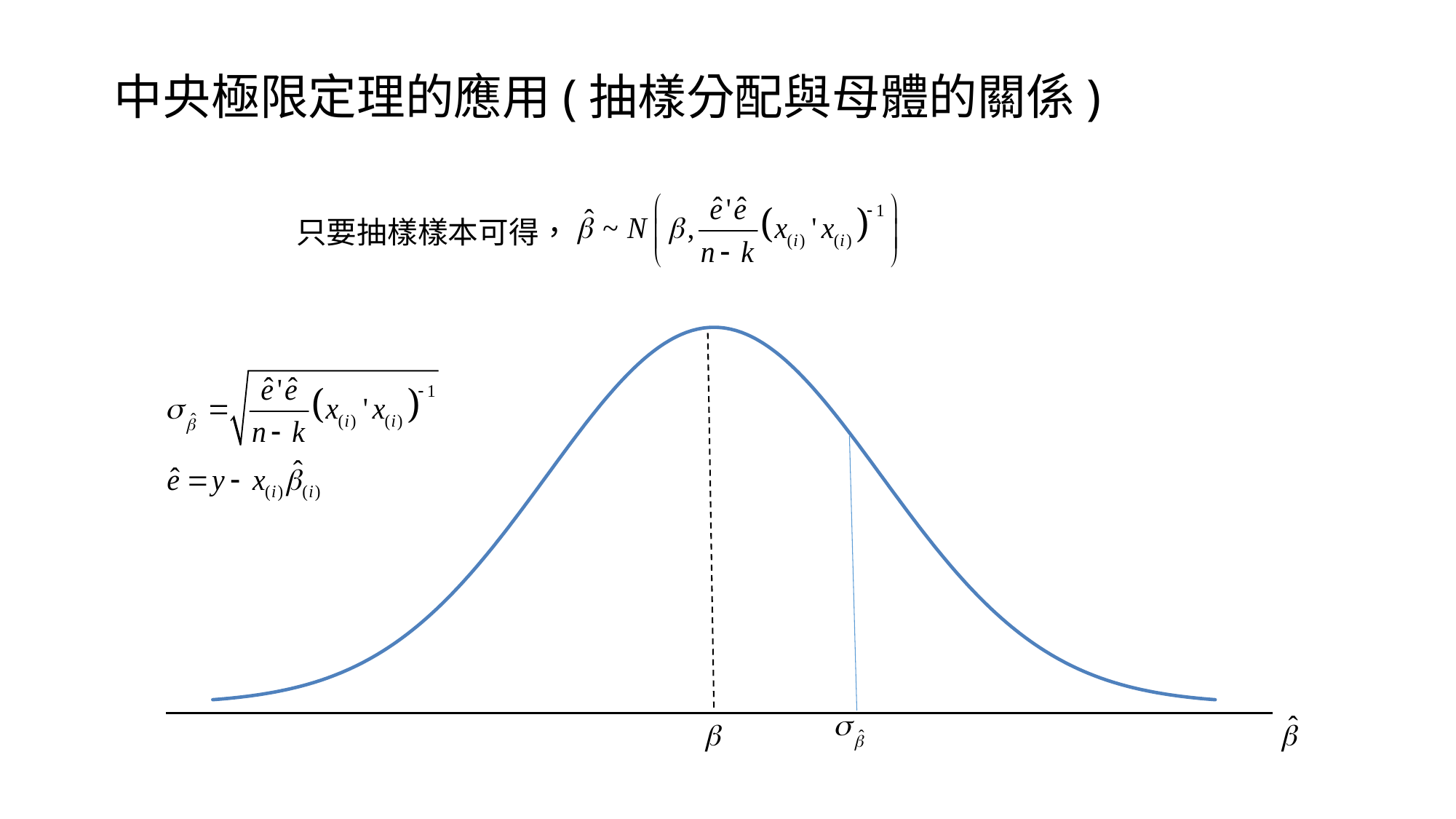
Does the curve rise or fall as it moves from the dashed line at β toward the right edge? fall How many curves (series) are plotted on the chart? 1 What kind of chart is shown on the slide? line chart What label is printed on the horizontal axis directly below the peak of the curve? β What colour is the bell-shaped curve on the chart? blue Does the curve rise or fall as it moves from the left edge toward the dashed line at β? rise